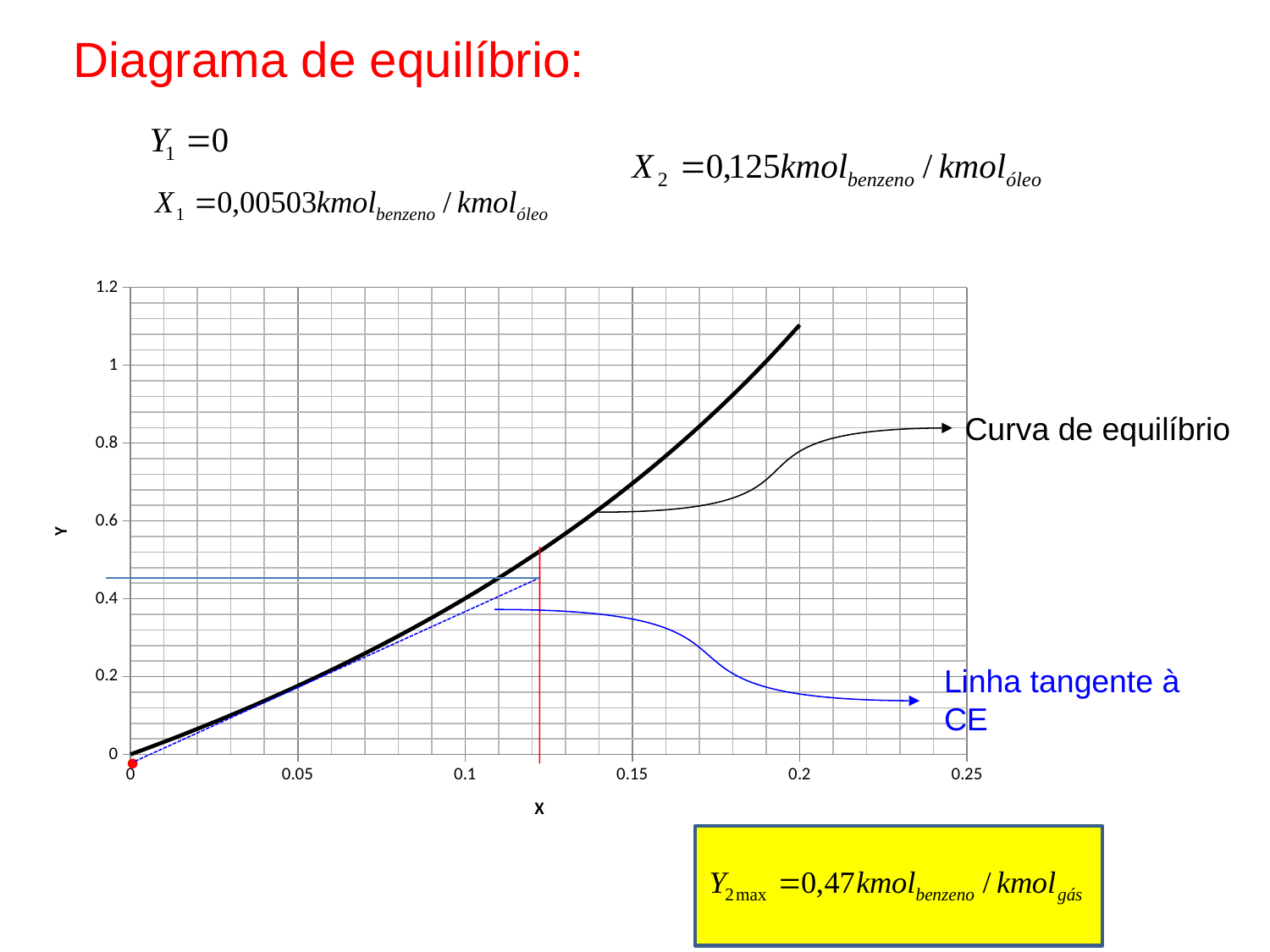
Which is larger, the value of the equilibrium curve at X = 0.2 or at X = 0.1? X = 0.2 Is the value of the equilibrium curve at X = 0.15 greater or less than 0.6? greater What is the highest tick value shown on the Y axis? 1.2 Does the equilibrium curve rise or fall as X increases? rises Is the value of the equilibrium curve at X = 0.05 greater or less than 0.4? less What kind of chart is shown on the slide? line chart Is the value of the equilibrium curve at X = 0.1 greater or less than 0.6? less What is the highest tick value shown on the X axis? 0.25